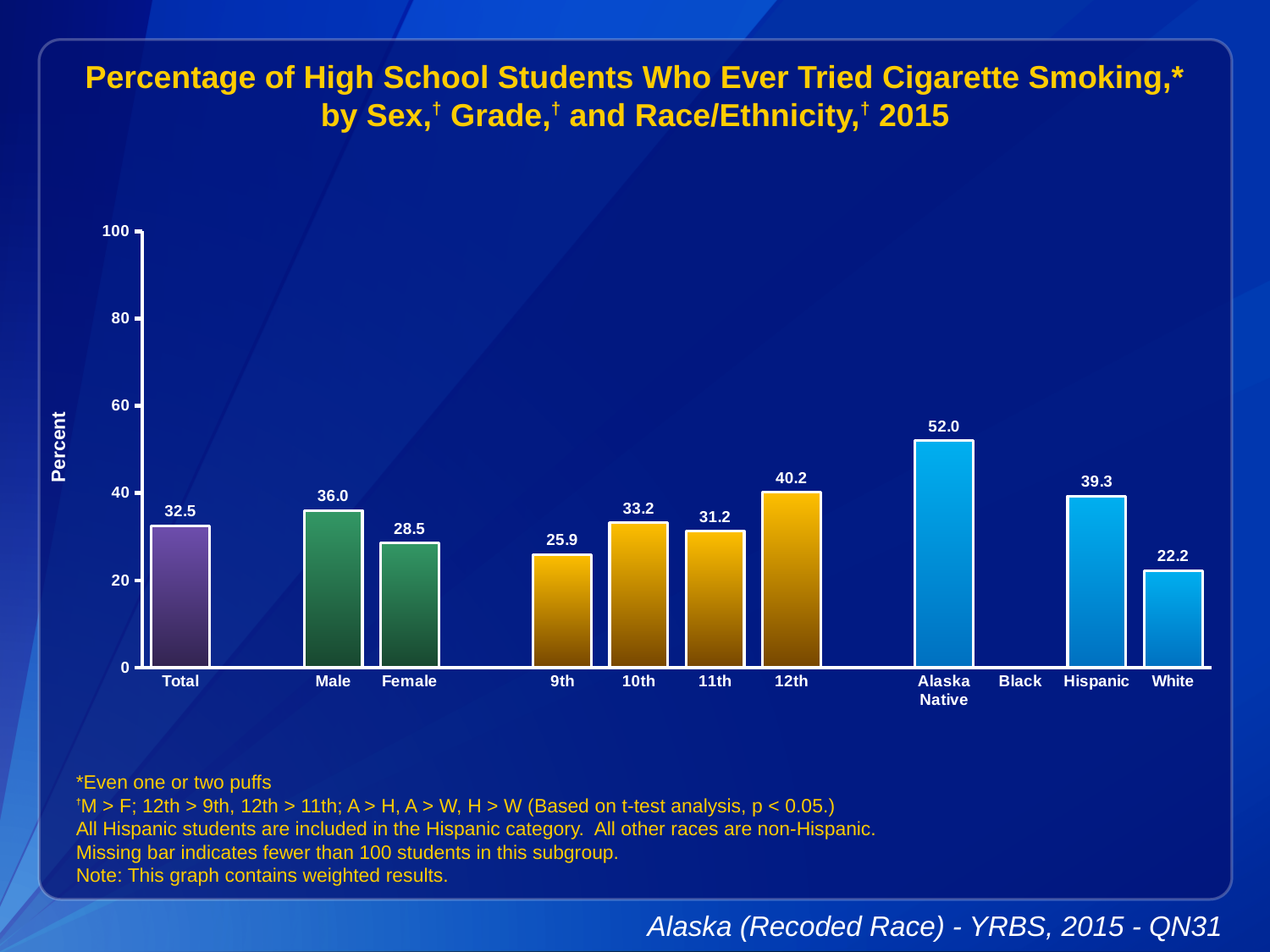
Which category has the highest value? Alaska Native What is the value for Total? 32.5 What is the value for 12th grade? 40.2 Which category has no bar shown on the chart? Black What is the value for Male? 36.0 How many categories have a bar plotted on the chart? 10 What is the difference between the Male and Female values? 7.5 Is the value for Alaska Native greater or less than 40? greater What is the value for Hispanic? 39.3 Which category has the lowest value among the bars shown? White What kind of chart is shown? bar chart Which is larger, the value for 10th grade or 11th grade? 10th